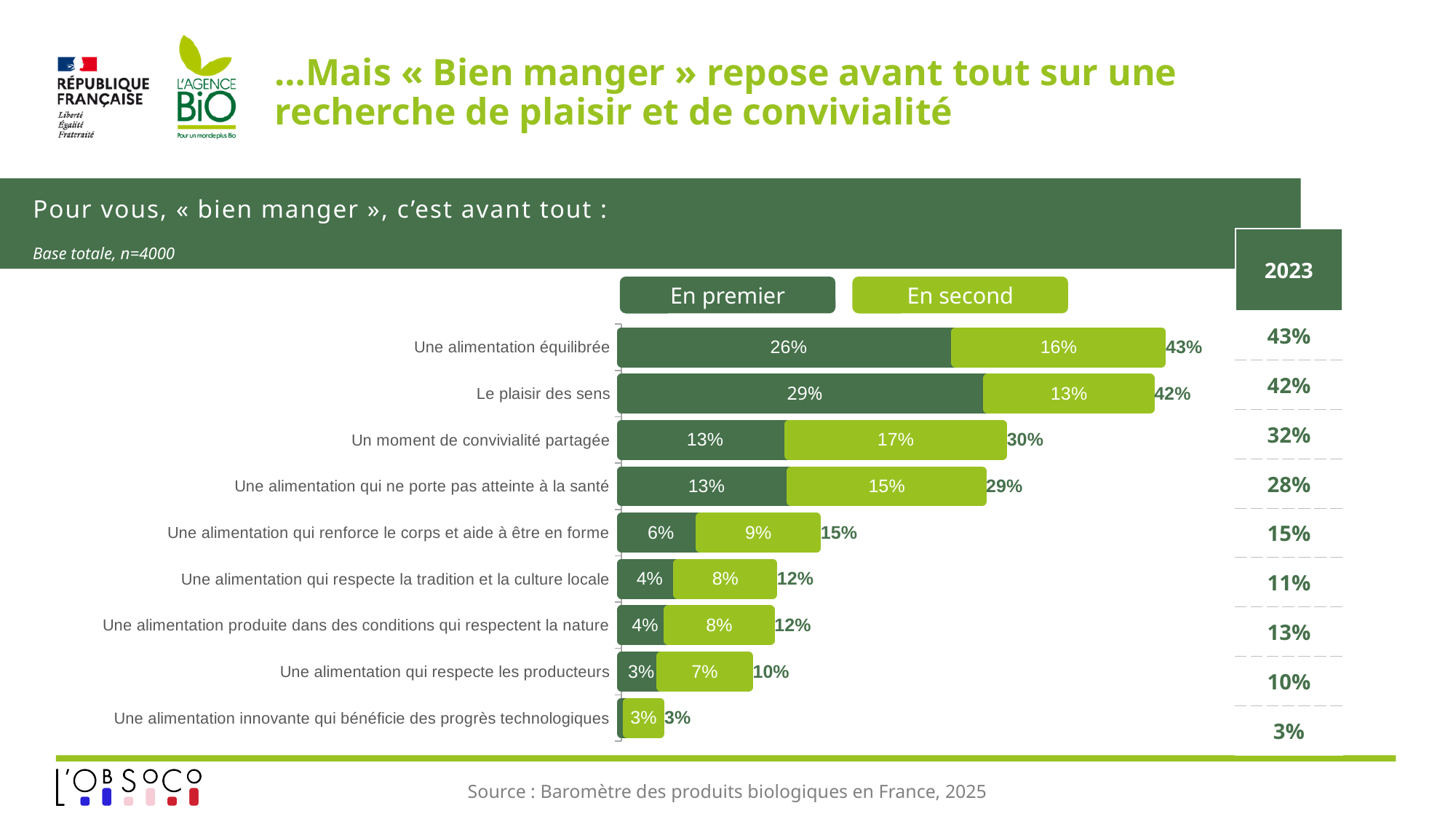
Which is larger: the "En second" value for "Une alimentation équilibrée" or for "Le plaisir des sens"? Une alimentation équilibrée What is the total printed at the end of the bar for "Une alimentation équilibrée"? 43% What kind of chart is shown on the slide? Stacked bar chart What is the "En premier" value for "Le plaisir des sens"? 29% How many categories are shown in the chart? 9 How many series does the legend list? 2 What is the "En second" value for "Un moment de convivialité partagée"? 17% Which category has the highest "En premier" value? Le plaisir des sens What is the 2023 value shown for "Un moment de convivialité partagée"? 32% What are the two legend entries of the chart? En premier, En second Which category has the lowest total? Une alimentation innovante qui bénéficie des progrès technologiques What is the difference between the "En premier" values for "Une alimentation équilibrée" and "Un moment de convivialité partagée"? 13%